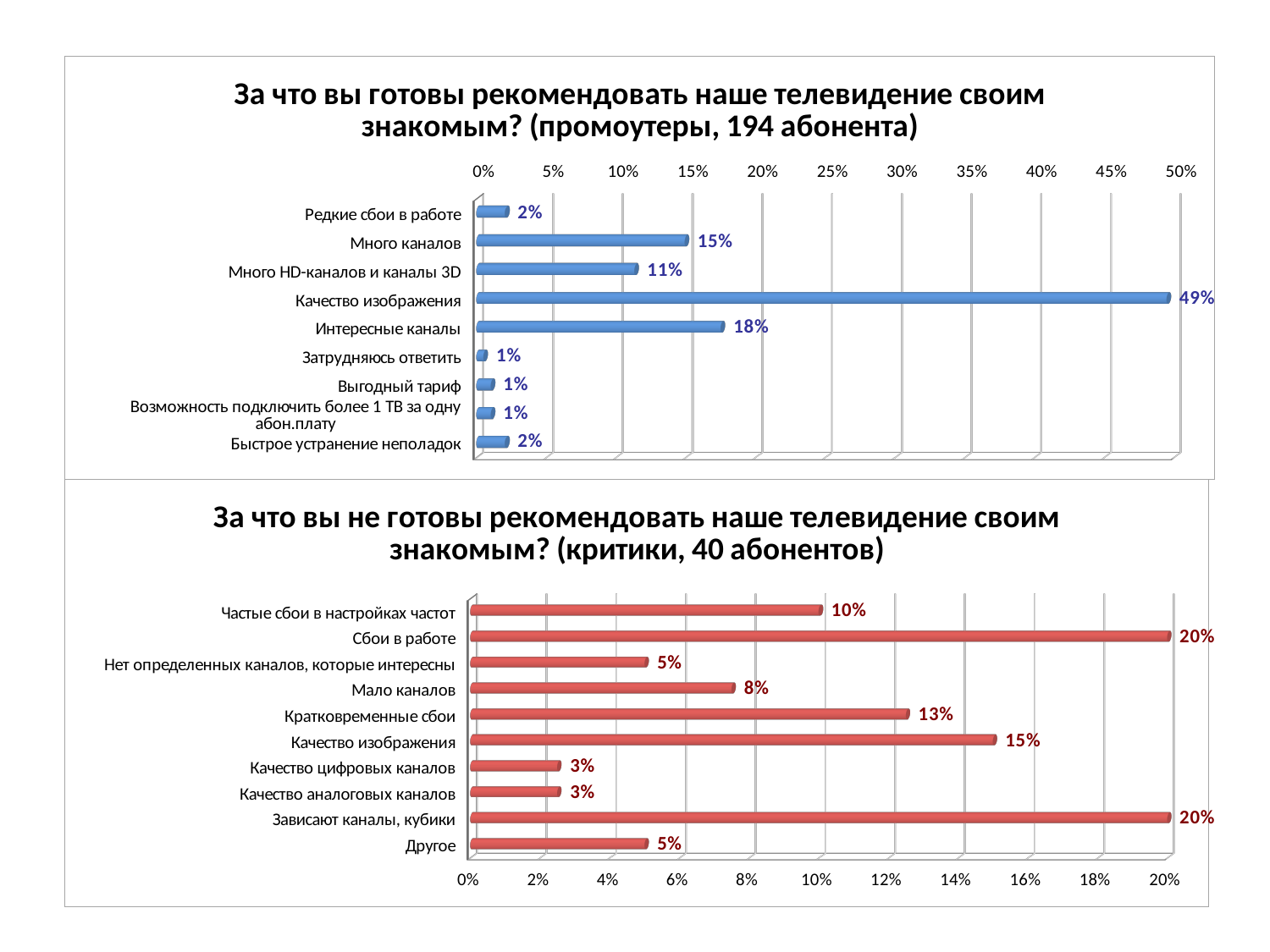
In the top chart (промоутеры, 194 абонента), what is the value for Интересные каналы? 18% In the top chart (промоутеры, 194 абонента), how many categories are shown? 9 In the bottom chart (критики, 40 абонентов), how many categories are shown? 10 In the top chart (промоутеры, 194 абонента), what is the difference between Много каналов and Много HD-каналов и каналы 3D? 4% In the top chart (промоутеры, 194 абонента), is the value for Много каналов greater or less than 10%? greater In the top chart (промоутеры, 194 абонента), which category has the highest value? Качество изображения In the top chart (промоутеры, 194 абонента), what is the value for Качество изображения? 49% In the bottom chart (критики, 40 абонентов), which is larger: Качество изображения or Частые сбои в настройках частот? Качество изображения In the bottom chart (критики, 40 абонентов), what is the value for Мало каналов? 8% In the bottom chart (критики, 40 абонентов), what is the value for Кратковременные сбои? 13% What type of chart is the bottom chart (критики, 40 абонентов)? Bar chart In the bottom chart (критики, 40 абонентов), what is the difference between Сбои в работе and Другое? 15%